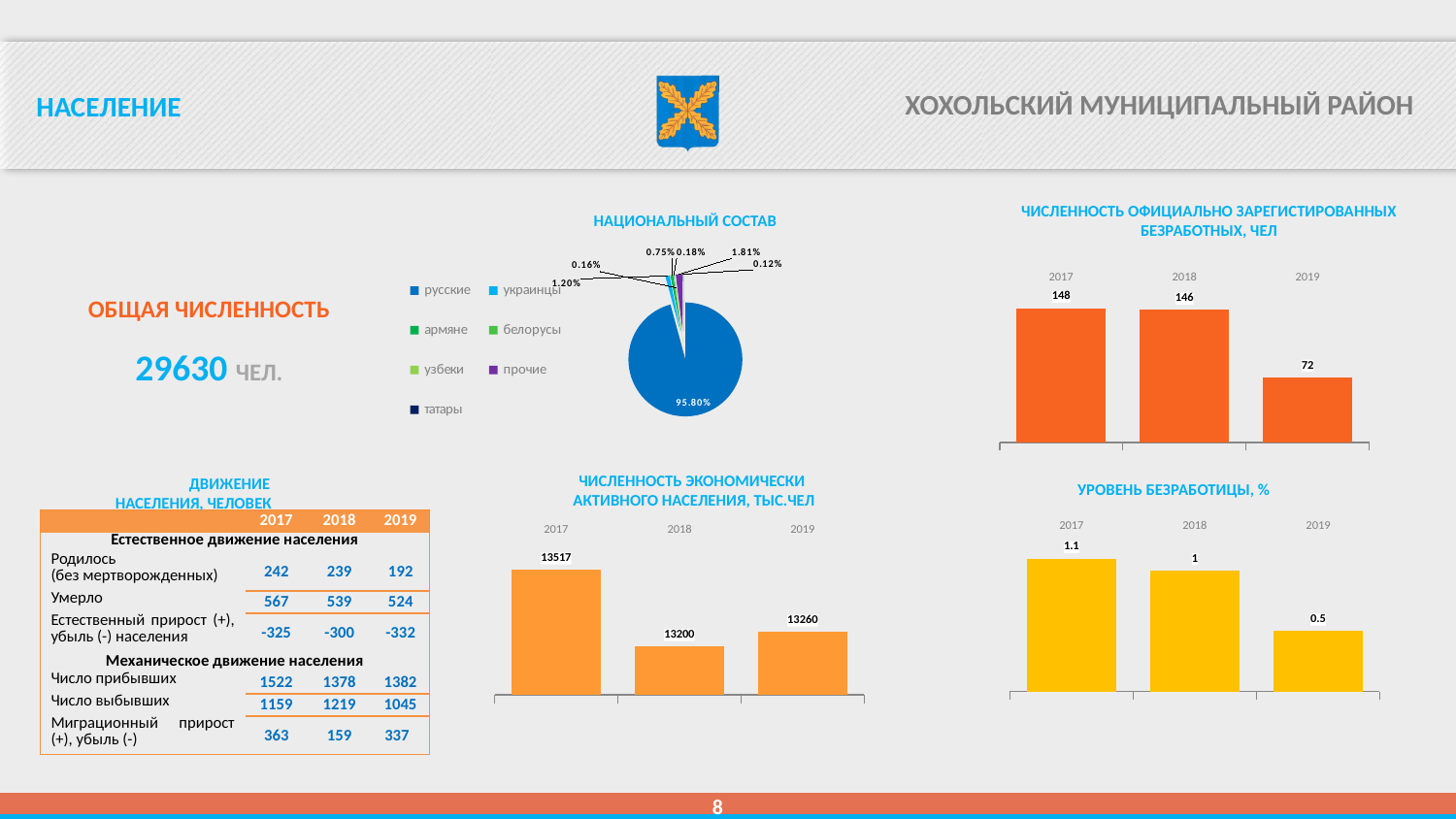
In the chart titled 'ЧИСЛЕННОСТЬ ЭКОНОМИЧЕСКИ АКТИВНОГО НАСЕЛЕНИЯ, ТЫС.ЧЕЛ', what is the difference between the 2017 and 2019 values? 257 In the chart titled 'УРОВЕНЬ БЕЗРАБОТИЦЫ, %', what is the value for 2019? 0.5 In the chart titled 'ЧИСЛЕННОСТЬ ОФИЦИАЛЬНО ЗАРЕГИСТРИРОВАННЫХ БЕЗРАБОТНЫХ, ЧЕЛ', what is the value for 2017? 148 In the chart titled 'УРОВЕНЬ БЕЗРАБОТИЦЫ, %', do the values rise or fall from 2017 to 2019? fall In the chart titled 'ЧИСЛЕННОСТЬ ОФИЦИАЛЬНО ЗАРЕГИСТРИРОВАННЫХ БЕЗРАБОТНЫХ, ЧЕЛ', what is the difference between the 2018 and 2019 values? 74 In the chart titled 'УРОВЕНЬ БЕЗРАБОТИЦЫ, %', which is larger, the value for 2017 or the value for 2019? 2017 In the chart titled 'УРОВЕНЬ БЕЗРАБОТИЦЫ, %', how many years are shown? 3 In the chart titled 'ЧИСЛЕННОСТЬ ЭКОНОМИЧЕСКИ АКТИВНОГО НАСЕЛЕНИЯ, ТЫС.ЧЕЛ', which year has the highest value? 2017 In the chart titled 'ЧИСЛЕННОСТЬ ЭКОНОМИЧЕСКИ АКТИВНОГО НАСЕЛЕНИЯ, ТЫС.ЧЕЛ', what is the value for 2018? 13200 What kind of chart is 'НАЦИОНАЛЬНЫЙ СОСТАВ'? pie chart In the chart titled 'ЧИСЛЕННОСТЬ ОФИЦИАЛЬНО ЗАРЕГИСТРИРОВАННЫХ БЕЗРАБОТНЫХ, ЧЕЛ', which year has the lowest value? 2019 In the pie chart 'НАЦИОНАЛЬНЫЙ СОСТАВ', what share does the 'русские' slice have? 95.80%